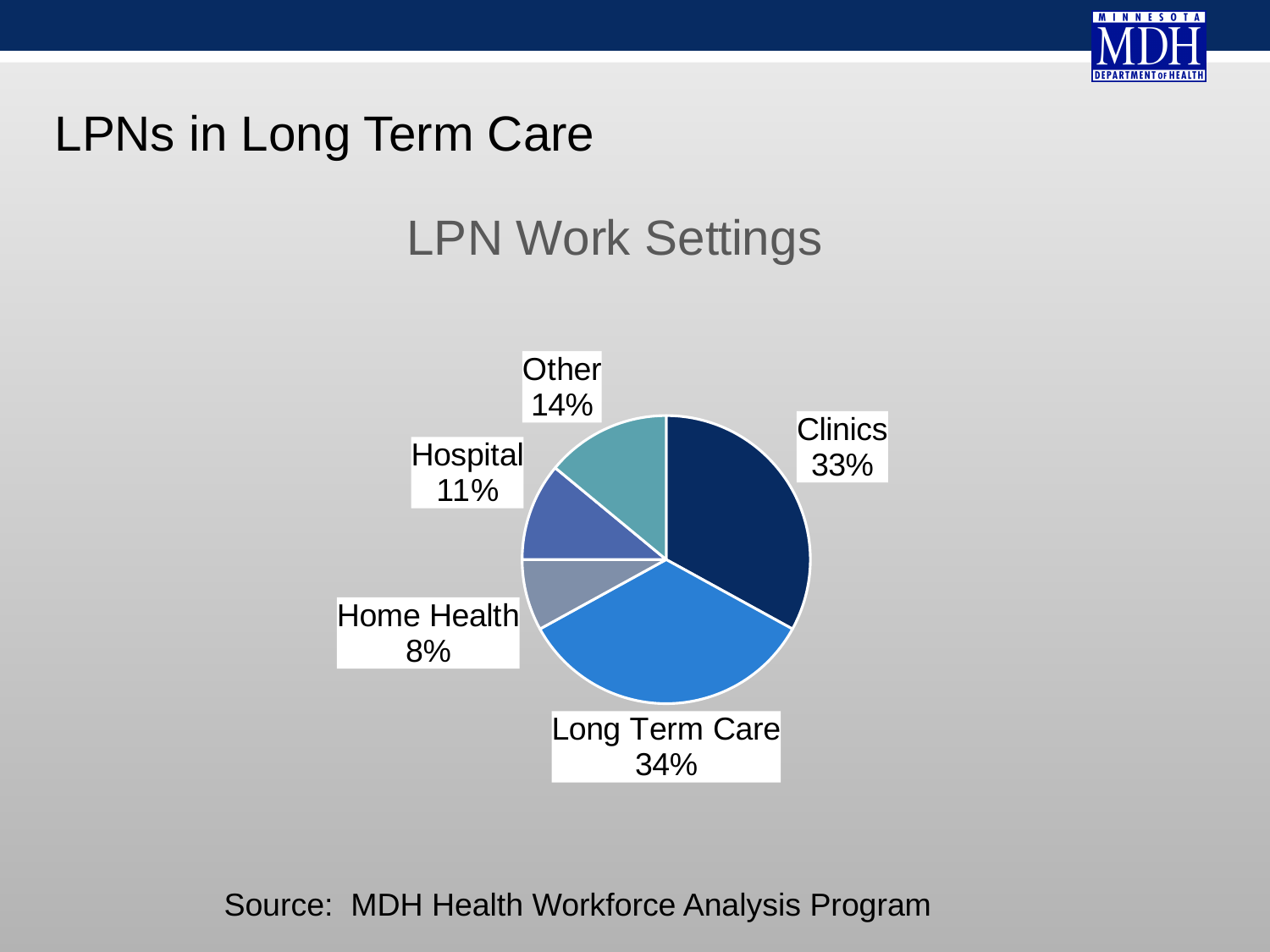
What is the title of the chart? LPN Work Settings Which work setting has the smallest share of LPNs? Home Health What percentage of LPNs work in Hospital settings? 11% Which is larger, the share for Other or the share for Hospital? Other How many work settings are shown in the pie chart? 5 What percentage of LPNs work in Home Health? 8% What is the combined share of Long Term Care and Clinics? 67% What percentage of LPNs work in Clinics? 33% What is the difference in percentage points between Long Term Care and Hospital? 23 What type of chart is shown on the slide? pie chart What percentage of LPNs work in Long Term Care? 34% What percentage of LPNs work in Other settings? 14%